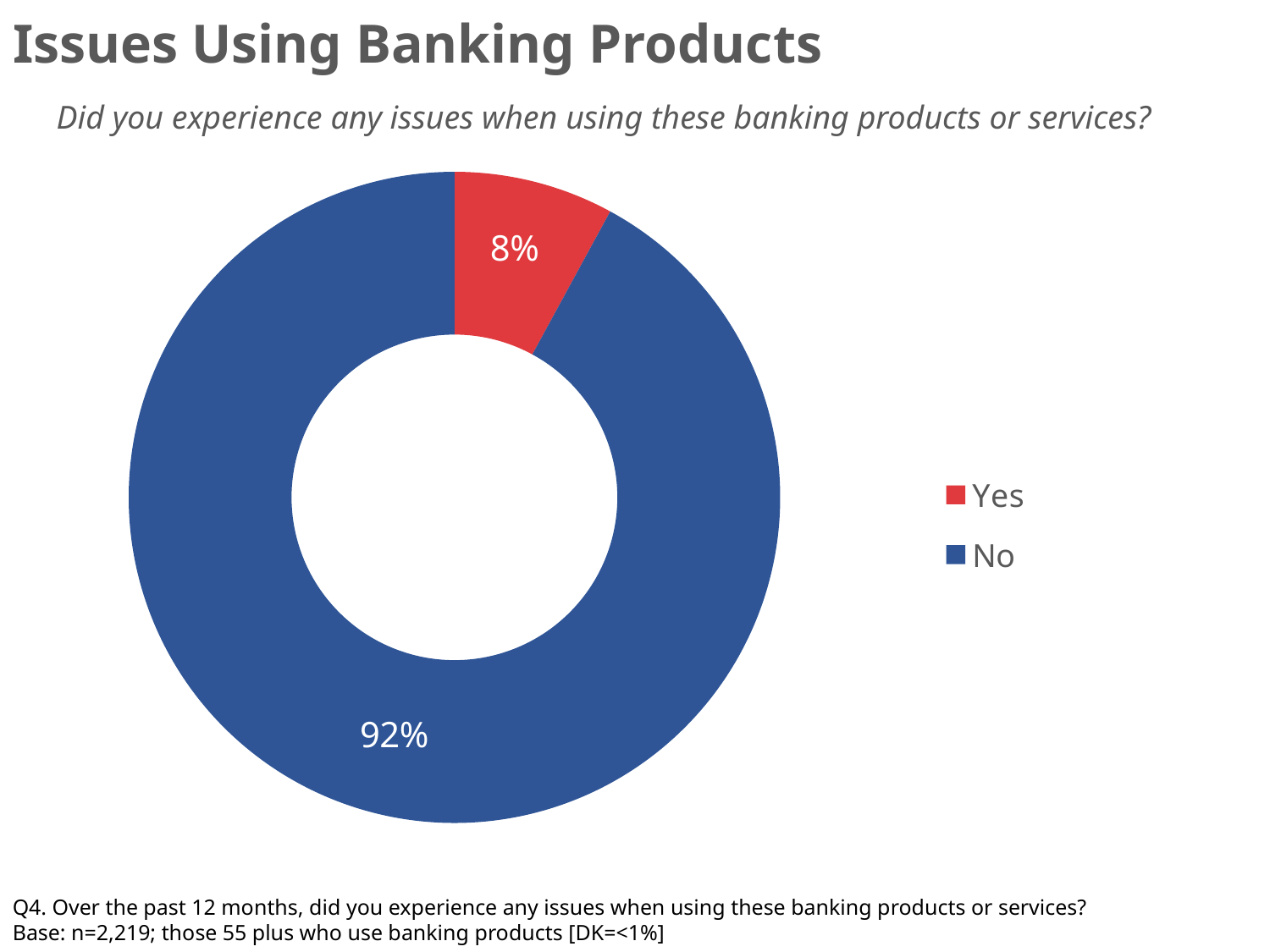
What percentage of respondents answered No to experiencing issues when using banking products or services? 92% How many categories are shown in the chart? 2 What share of the pie does the Yes slice represent? 8% What is the difference in percentage points between the No and Yes responses? 84 Which response has the largest share of the chart? No What percentage of respondents answered Yes to experiencing issues when using banking products or services? 8% What is the title of the slide? Issues Using Banking Products What colour is used for the No segment? Blue What kind of chart is shown on the slide? Pie chart (doughnut) How many entries does the legend list? 2 Which is larger, the share for Yes or the share for No? No Which response has the smallest share of the chart? Yes